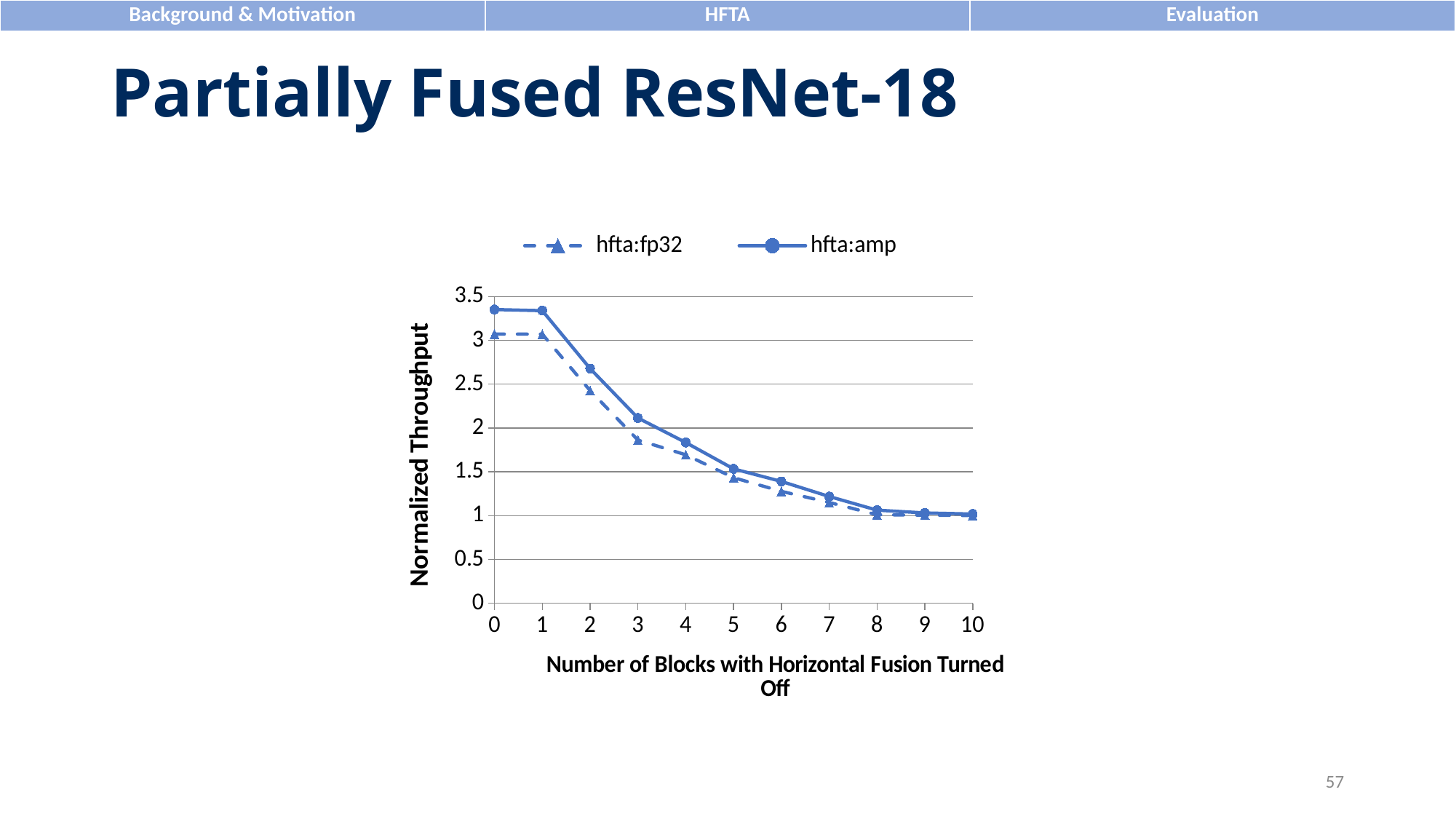
What kind of chart is shown on the slide? line chart Which series is drawn with a dashed line and triangle markers? hfta:fp32 Is the hfta:amp value at 0 blocks greater or less than 3? greater Does normalized throughput rise or fall as the number of blocks with horizontal fusion turned off increases? fall How many series does the legend list? 2 At 2 blocks with horizontal fusion turned off, which series has the higher normalized throughput? hfta:amp What is the label of the y axis? Normalized Throughput Is the hfta:fp32 value at 2 blocks greater or less than 2.5? less How many x-axis values (number of blocks) are plotted for each series? 11 At 0 blocks, which series has the higher normalized throughput? hfta:amp Is the hfta:amp value at 3 blocks greater or less than 2? greater